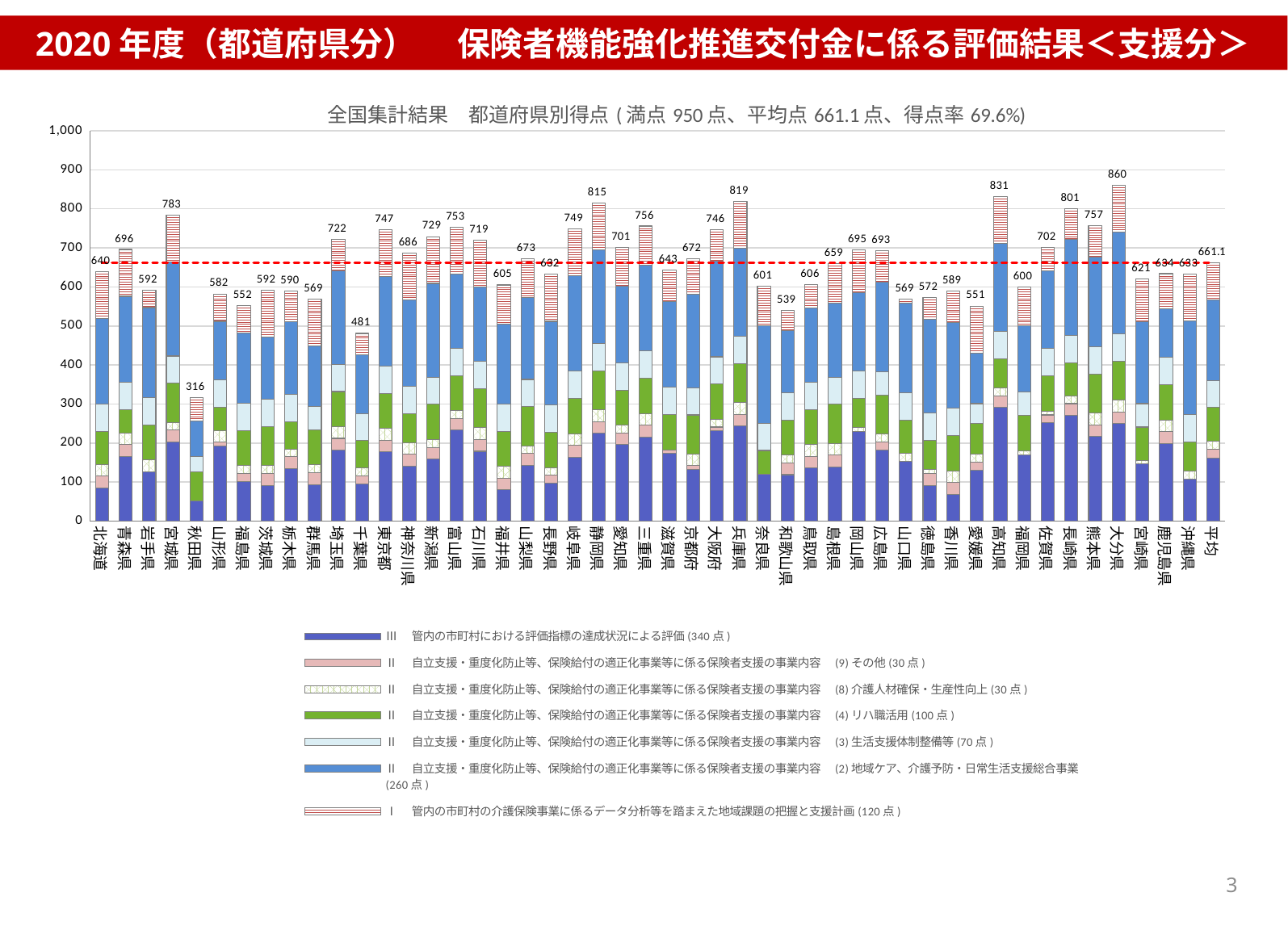
Which prefecture has the highest total score? 大分県 What is the difference between the total scores of 大分県 and 秋田県? 544 What is the total score shown for 秋田県? 316 Is the total score for 千葉県 greater or less than 500? less What kind of chart is shown on the slide? Stacked bar chart What is the total score shown for 大分県? 860 What average score (平均点) is stated in the chart title? 661.1 点 How many series does the legend list? 7 What is the total score shown for 高知県? 831 Which prefecture has the lowest total score? 秋田県 What is the value shown for 平均 (the average bar)? 661.1 Which has a higher total score, 宮城県 or 埼玉県? 宮城県